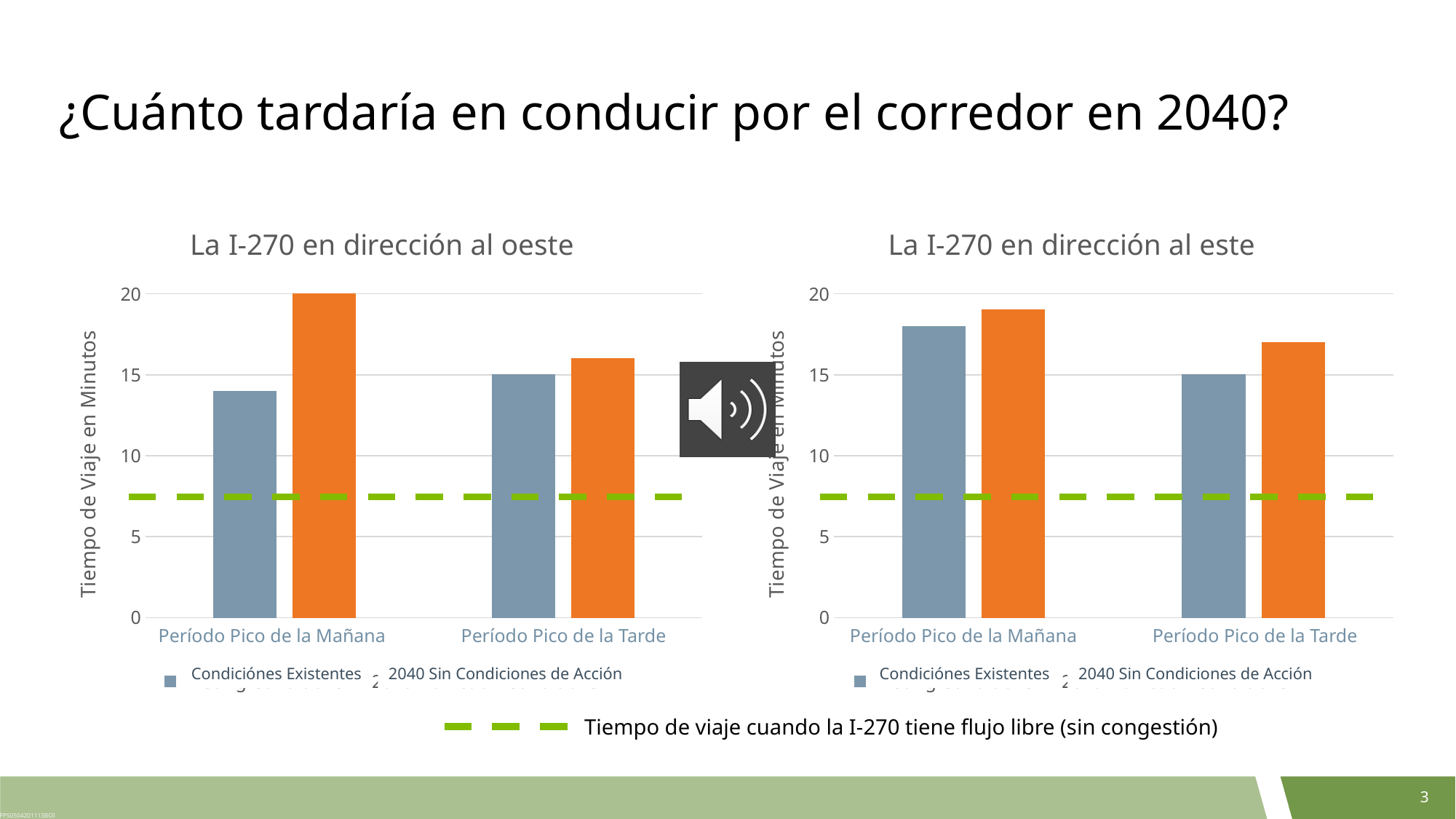
In the chart titled 'La I-270 en dirección al este', is the value for 'Condiciónes Existentes' in 'Período Pico de la Mañana' greater or less than 15? greater In the chart titled 'La I-270 en dirección al este', how many categories are shown on the x axis? 2 In the chart titled 'La I-270 en dirección al oeste', what is the value for 'Condiciónes Existentes' in 'Período Pico de la Tarde'? 15 In the chart titled 'La I-270 en dirección al este', what is the value for 'Condiciónes Existentes' in 'Período Pico de la Tarde'? 15 In the chart titled 'La I-270 en dirección al este', which is larger for '2040 Sin Condiciones de Acción': 'Período Pico de la Mañana' or 'Período Pico de la Tarde'? Período Pico de la Mañana In the chart titled 'La I-270 en dirección al oeste', how many series does the legend list? 2 In the chart titled 'La I-270 en dirección al oeste', which bar is the highest? 2040 Sin Condiciones de Acción, Período Pico de la Mañana In the chart titled 'La I-270 en dirección al oeste', what is the value for '2040 Sin Condiciones de Acción' in 'Período Pico de la Mañana'? 20 In the chart titled 'La I-270 en dirección al oeste', is the value for '2040 Sin Condiciones de Acción' in 'Período Pico de la Tarde' greater or less than 15? greater In the chart titled 'La I-270 en dirección al oeste', is the value for 'Condiciónes Existentes' in 'Período Pico de la Mañana' greater or less than 15? less In the chart titled 'La I-270 en dirección al oeste', what kind of chart is shown? bar chart In the chart titled 'La I-270 en dirección al este', what is the y-axis label? Tiempo de Viaje en Minutos